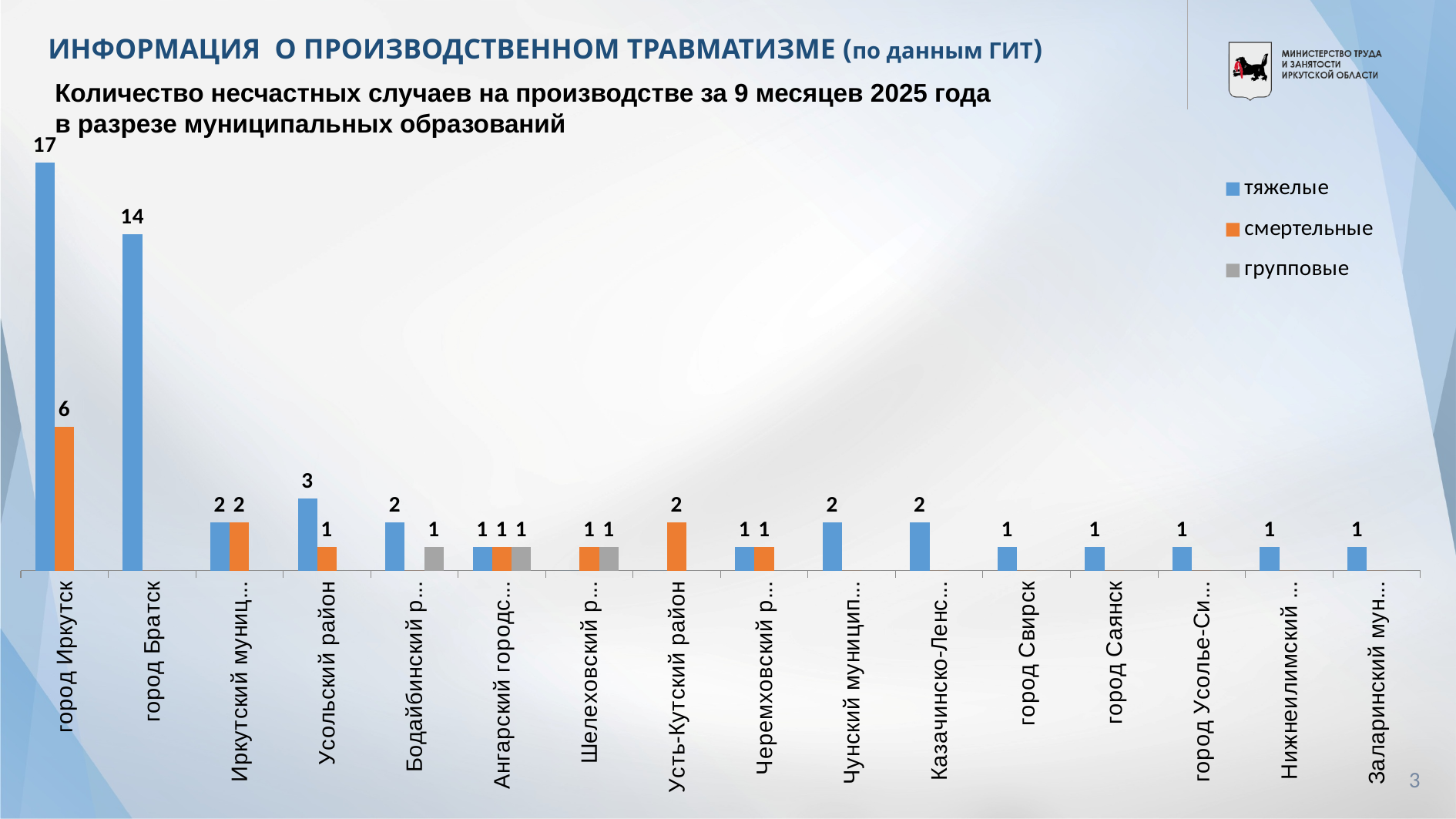
What is the value of тяжелые for город Братск? 14 What is the value of смертельные for Усть-Кутский район? 2 Which municipality has the highest value of тяжелые? город Иркутск What is the value of тяжелые for Усольский район? 3 Which is larger: the тяжелые value for город Братск or the смертельные value for город Иркутск? город Братск тяжелые What type of chart is shown on the slide? bar chart How many municipalities (categories) are shown on the x axis? 16 Which legend entry is shown in orange? смертельные What is the value of тяжелые for город Иркутск? 17 What is the difference between the тяжелые values for город Иркутск and город Братск? 3 How many series does the legend list? 3 What is the value of смертельные for город Иркутск? 6